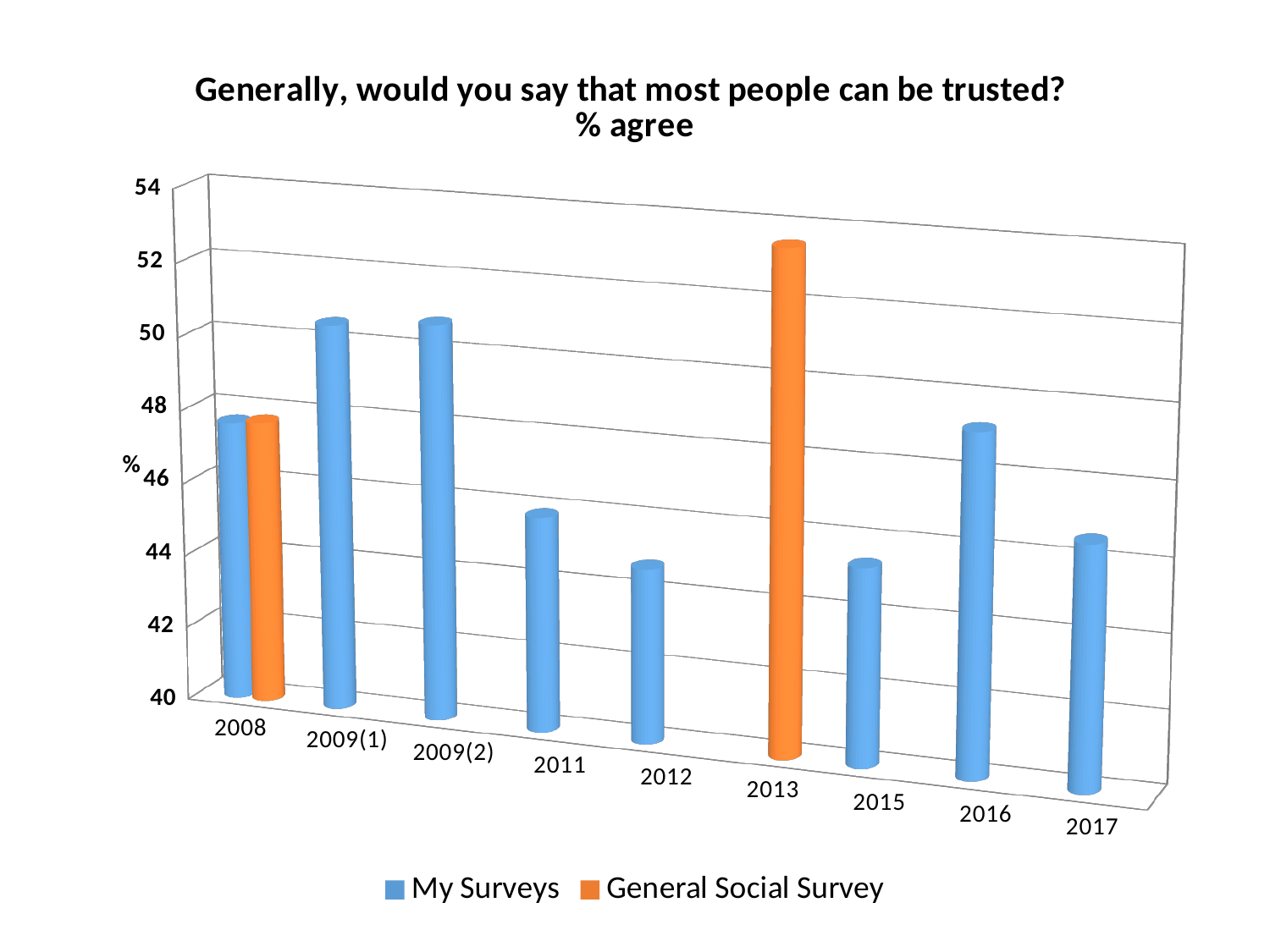
Which is larger for My Surveys: the value for 2009(1) or the value for 2011? 2009(1) Is the General Social Survey value for 2013 greater or less than 50? greater Which is larger for My Surveys: the value for 2016 or the value for 2017? 2016 Is the My Surveys value for 2009(1) greater or less than 48? greater How many categories are shown on the x axis? 9 How many series does the legend list? 2 Is the My Surveys value for 2011 greater or less than 46? less Which bar is the highest on the chart? General Social Survey, 2013 What is the title of the chart? Generally, would you say that most people can be trusted? % agree Which series is shown in orange? General Social Survey What kind of chart is shown on the slide? bar chart